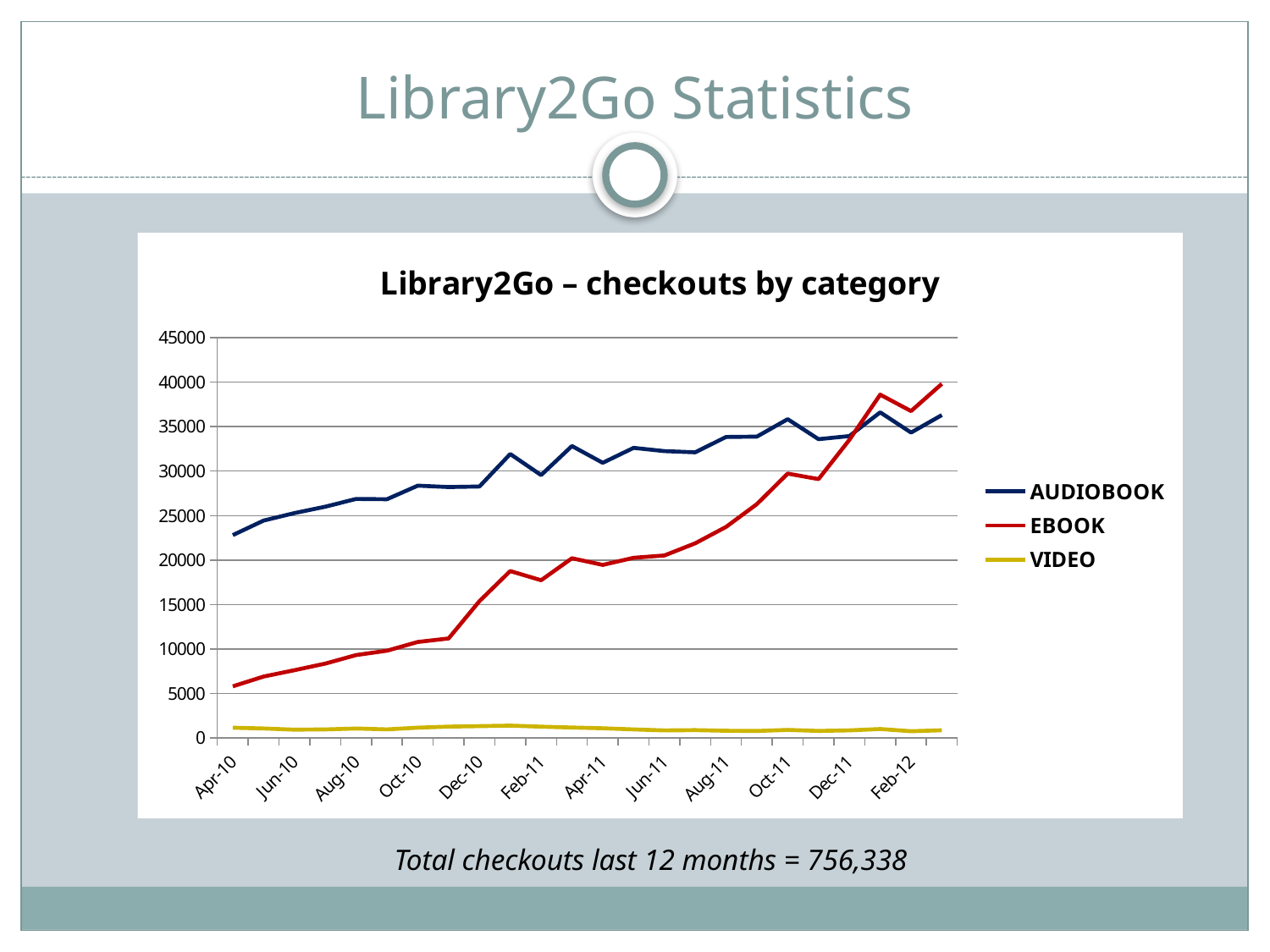
Do EBOOK checkouts generally rise or fall from Apr-10 to Feb-12? rise Which series has the lowest values across the whole period? VIDEO Is the AUDIOBOOK value for Oct-11 greater or less than 30000? greater Which series has the higher value at Apr-10, AUDIOBOOK or EBOOK? AUDIOBOOK What is the title of the chart? Library2Go – checkouts by category What kind of chart is shown on the slide? line chart Is the AUDIOBOOK value for Apr-10 greater or less than 20000? greater How many series does the legend list? 3 Is the EBOOK value for Apr-10 greater or less than 10000? less Which series is drawn in red? EBOOK